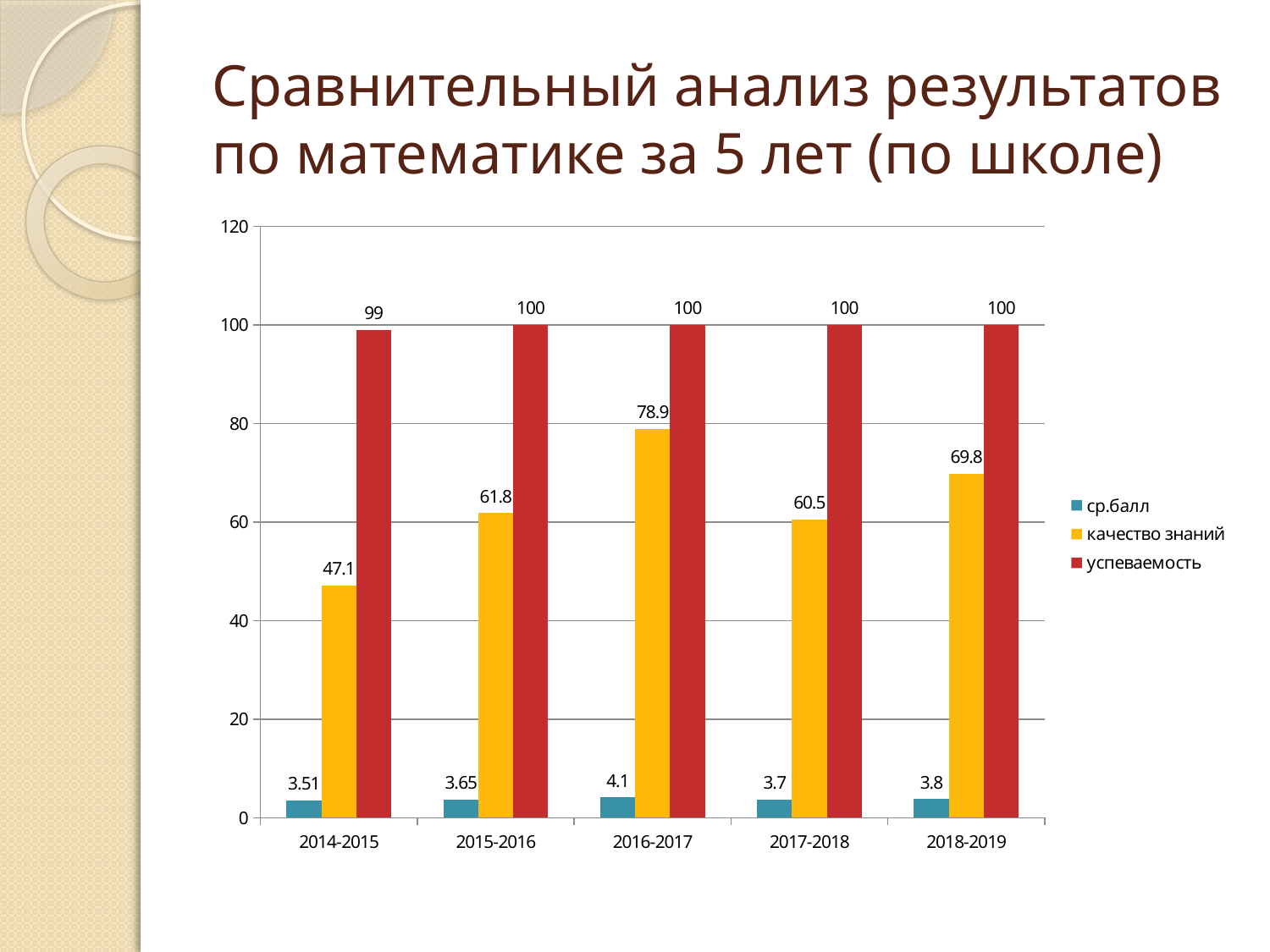
What is the value of качество знаний for 2016-2017? 78.9 Which series is shown in red? успеваемость Which is larger: качество знаний in 2015-2016 or in 2017-2018? 2015-2016 How many series does the legend list? 3 Is the value of качество знаний for 2018-2019 greater or less than 60? greater What is the value of успеваемость for 2014-2015? 99 What is the difference between качество знаний in 2016-2017 and in 2014-2015? 31.8 How many school years are shown on the x axis? 5 What kind of chart is shown on the slide? bar chart What is the value of ср.балл for 2014-2015? 3.51 Which year has the highest value for качество знаний? 2016-2017 Which year has the lowest value for ср.балл? 2014-2015